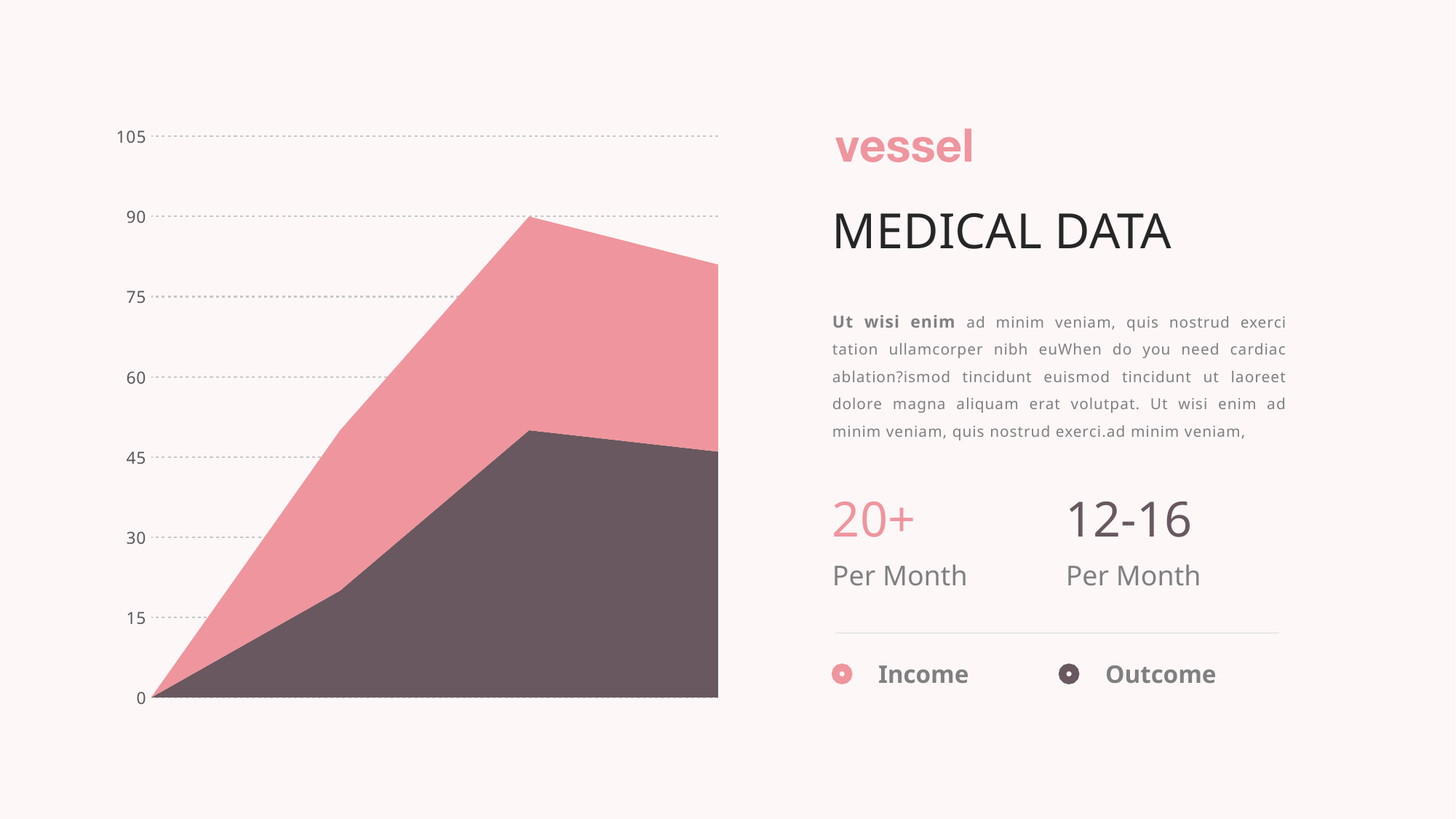
What kind of chart is shown on the slide? area chart Is the highest value of the Outcome series greater or less than 45? greater What are the two series named in the legend? Income and Outcome Is the value of the Income series at the last point greater or less than 90? less Is the highest value of the Outcome series greater or less than 60? less Does the Income series rise or fall between the first point and the third point? rise How many data points does each series have? 4 How many series does the legend list? 2 Which colour represents the Income series? pink